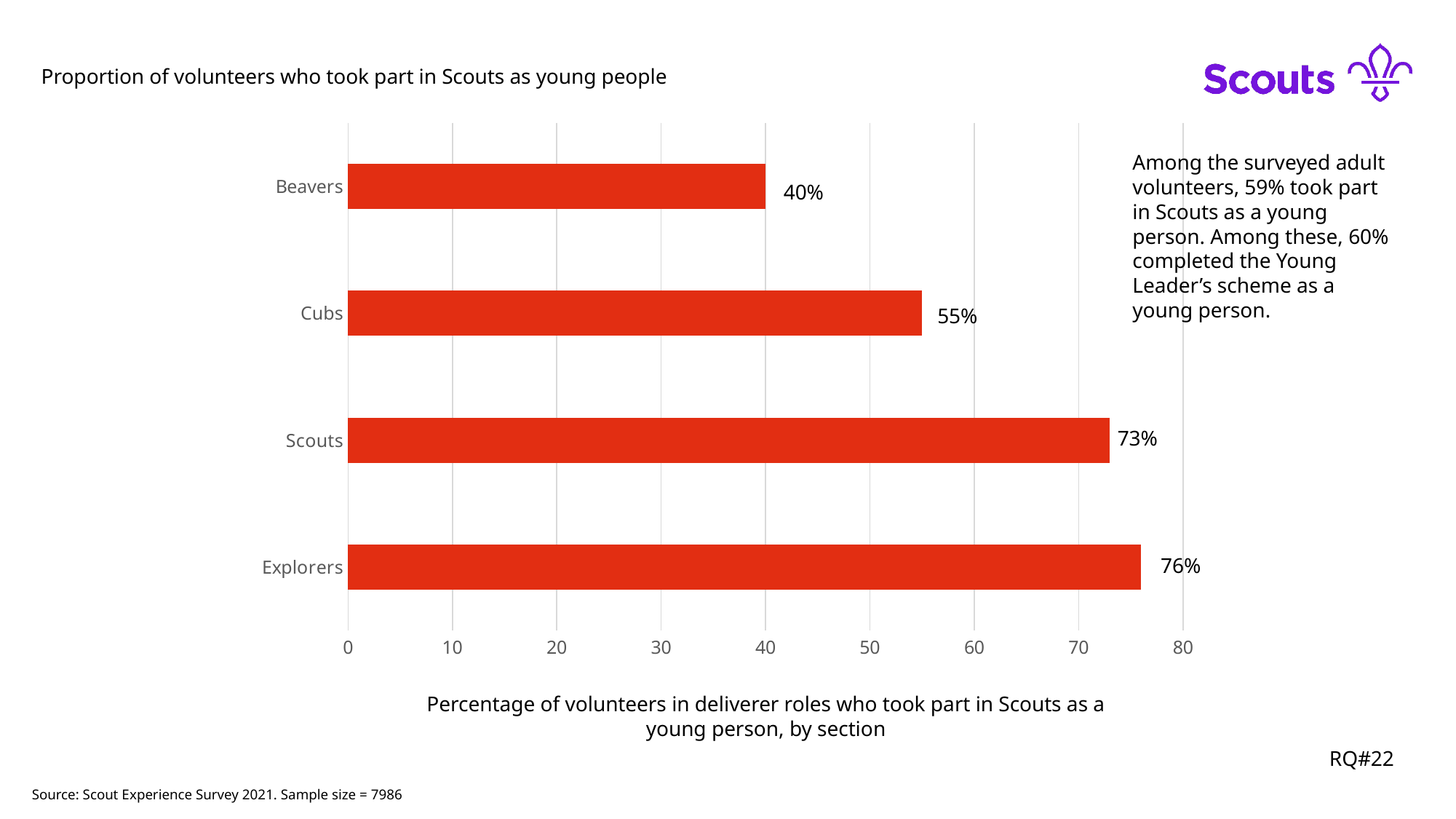
Which has a higher value, Cubs or Beavers? Cubs What percentage of volunteers in the Beavers section took part in Scouts as a young person? 40% How many sections are shown in the chart? 4 What is the title of the chart on the slide? Proportion of volunteers who took part in Scouts as young people What is the difference in percentage points between Explorers and Beavers? 36 What type of chart is shown on the slide? Bar chart What is the value shown for Explorers? 76% What is the difference in percentage points between Scouts and Cubs? 18 Which section has the highest proportion of volunteers who took part in Scouts as young people? Explorers Which section has the lowest proportion of volunteers who took part in Scouts as young people? Beavers What is the value shown for Cubs? 55% What is the value shown for Scouts? 73%